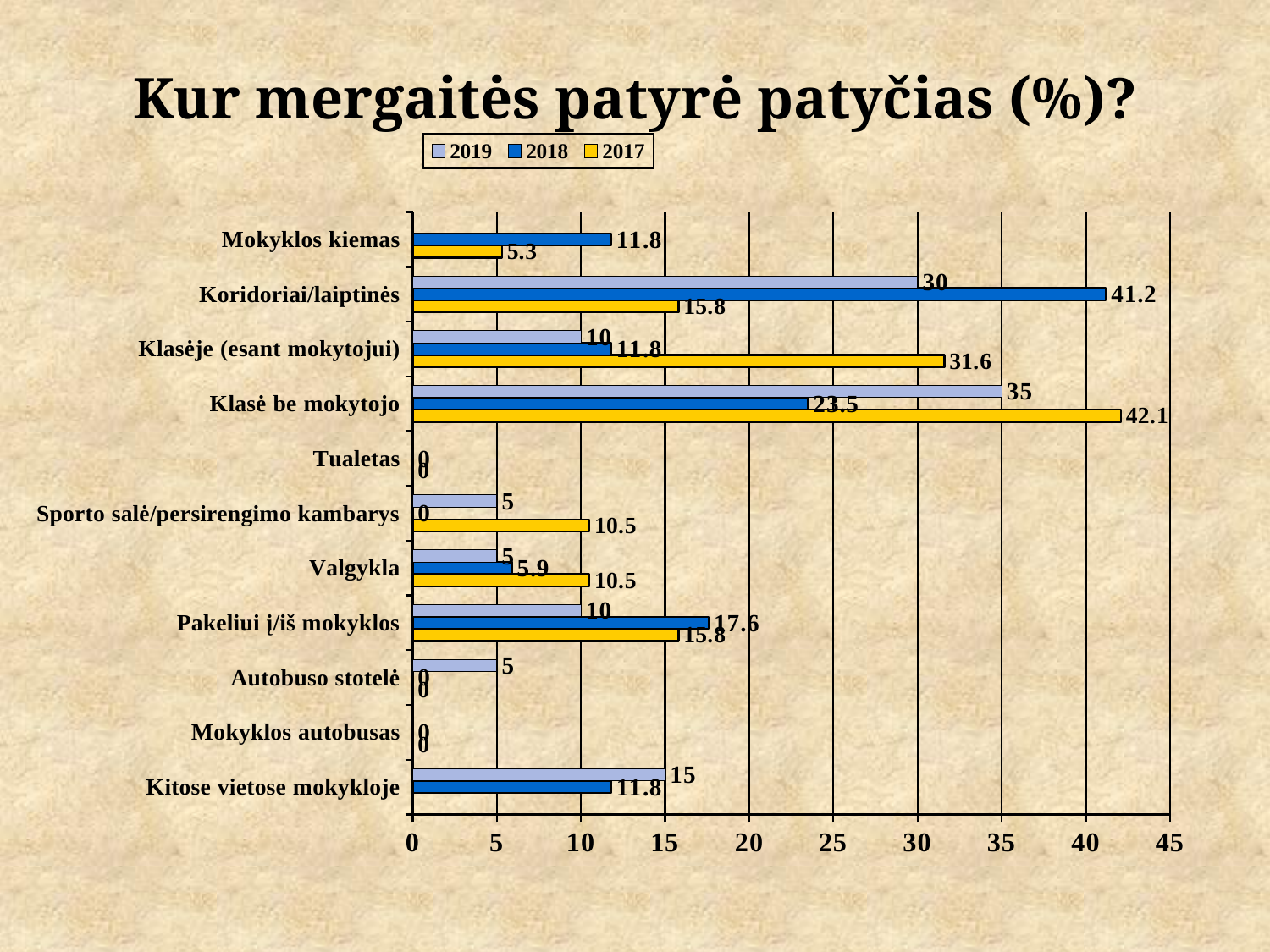
What is the 2018 value for Pakeliui į/iš mokyklos? 17.6 What kind of chart is shown on the slide? Bar chart Which category has the highest 2019 value? Klasė be mokytojo For Klasėje (esant mokytojui), which year has the larger value, 2017 or 2018? 2017 How many series does the legend list? 3 What is the 2018 value for Koridoriai/laiptinės? 41.2 What is the 2017 value for Klasė be mokytojo? 42.1 Which category has the highest 2017 value? Klasė be mokytojo How many categories are shown on the chart? 11 Which category has the highest 2018 value? Koridoriai/laiptinės What is the difference between the 2018 and 2019 values for Koridoriai/laiptinės? 11.2 What is the difference between the 2017 and 2019 values for Klasė be mokytojo? 7.1